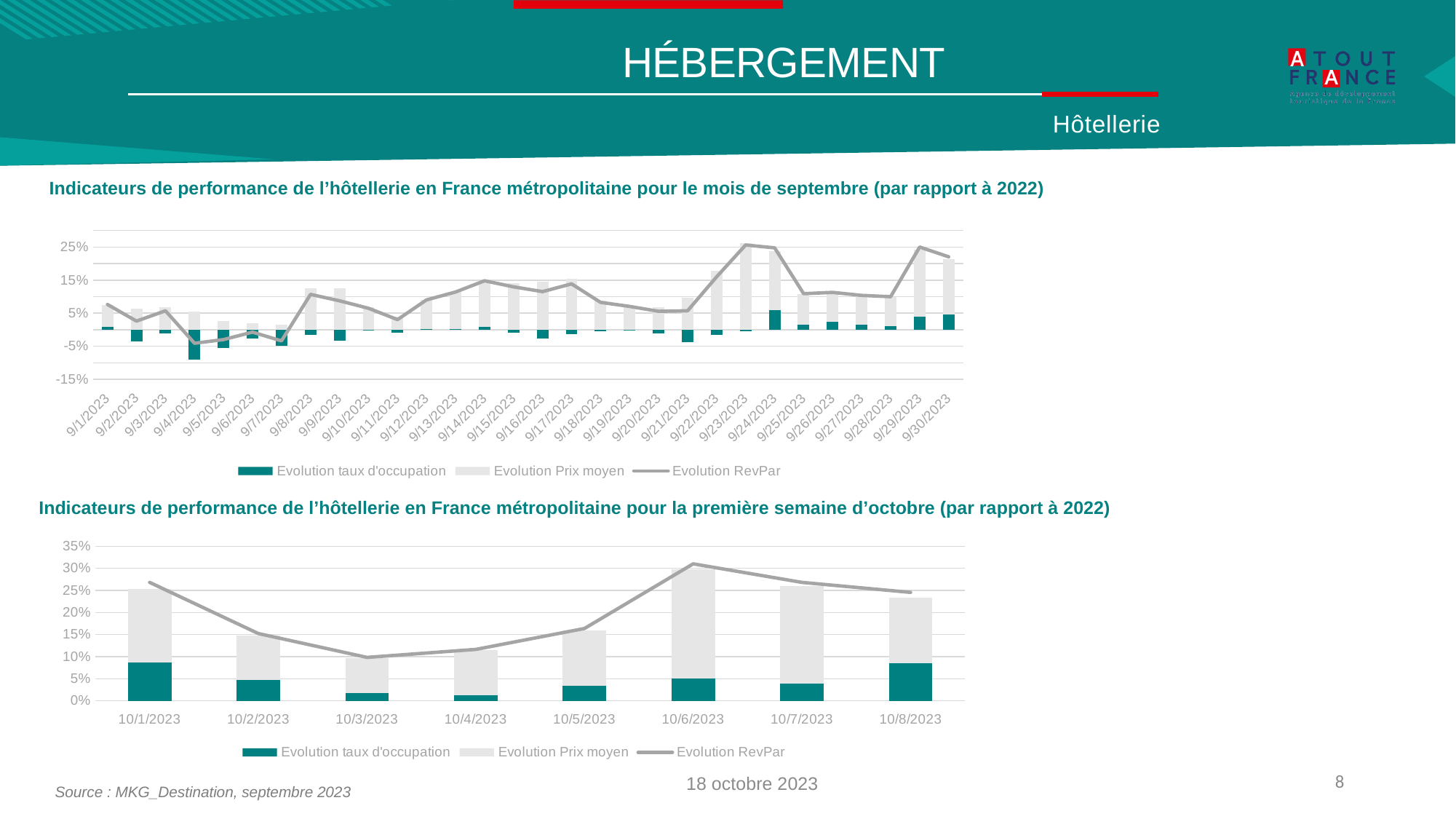
On the bottom chart (première semaine d'octobre), does Evolution RevPar rise or fall from 10/3/2023 to 10/6/2023? rise On the top chart (mois de septembre), is the value of Evolution RevPar for 9/23/2023 greater or less than 15%? greater On the bottom chart (première semaine d'octobre), how many dates are shown on the x axis? 8 On the bottom chart (première semaine d'octobre), is the value of Evolution RevPar for 10/3/2023 greater or less than 15%? less On the bottom chart (première semaine d'octobre), which is larger, Evolution RevPar for 10/1/2023 or for 10/2/2023? 10/1/2023 On the top chart (mois de septembre), how many series does the legend list? 3 On the bottom chart (première semaine d'octobre), on which date is Evolution RevPar lowest? 10/3/2023 On the bottom chart (première semaine d'octobre), is the value of Evolution RevPar for 10/6/2023 greater or less than 25%? greater On the bottom chart (première semaine d'octobre), on which date is Evolution RevPar highest? 10/6/2023 On the top chart (mois de septembre), which series is drawn in teal bars? Evolution taux d'occupation On the top chart (mois de septembre), on which date is Evolution taux d'occupation lowest? 9/4/2023 On the bottom chart (première semaine d'octobre), what kind of chart is used for the Evolution RevPar series? Line chart